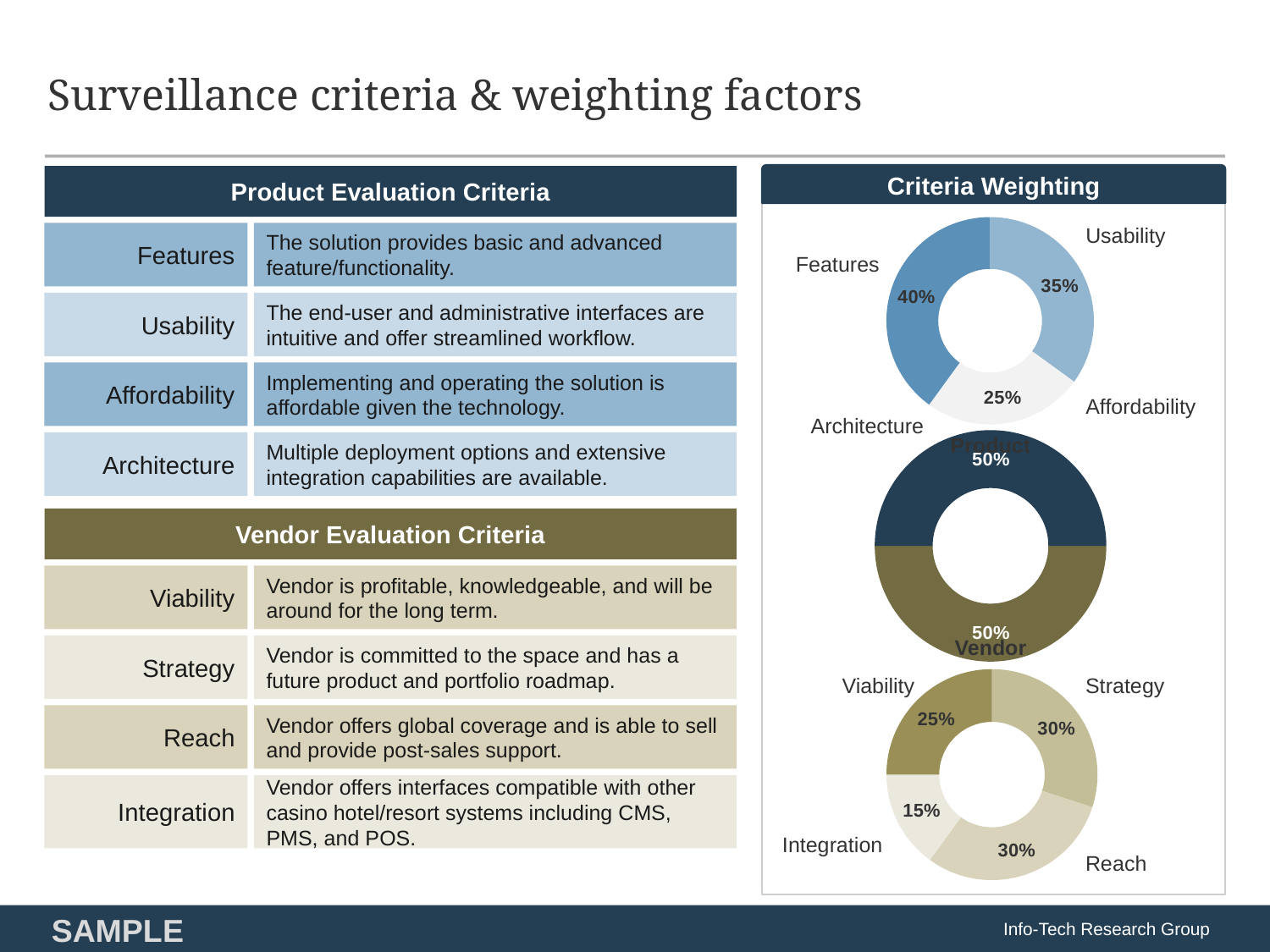
In the middle donut chart under Criteria Weighting, what is the weighting for Product? 50% In the bottom donut chart under Criteria Weighting, which is larger, the weighting for Strategy or for Viability? Strategy In the bottom donut chart under Criteria Weighting, which criterion has the lowest weighting? Integration In the top donut chart under Criteria Weighting, what is the weighting for Usability? 35% In the middle donut chart under Criteria Weighting, what is the weighting for Vendor? 50% In the bottom donut chart under Criteria Weighting, what is the weighting for Viability? 25% In the bottom donut chart under Criteria Weighting, what is the weighting for Integration? 15% In the top donut chart under Criteria Weighting, what is the weighting for Features? 40% In the top donut chart under Criteria Weighting, which labelled criterion has the highest weighting? Features What kind of chart is used to show the Criteria Weighting? Donut (pie) chart